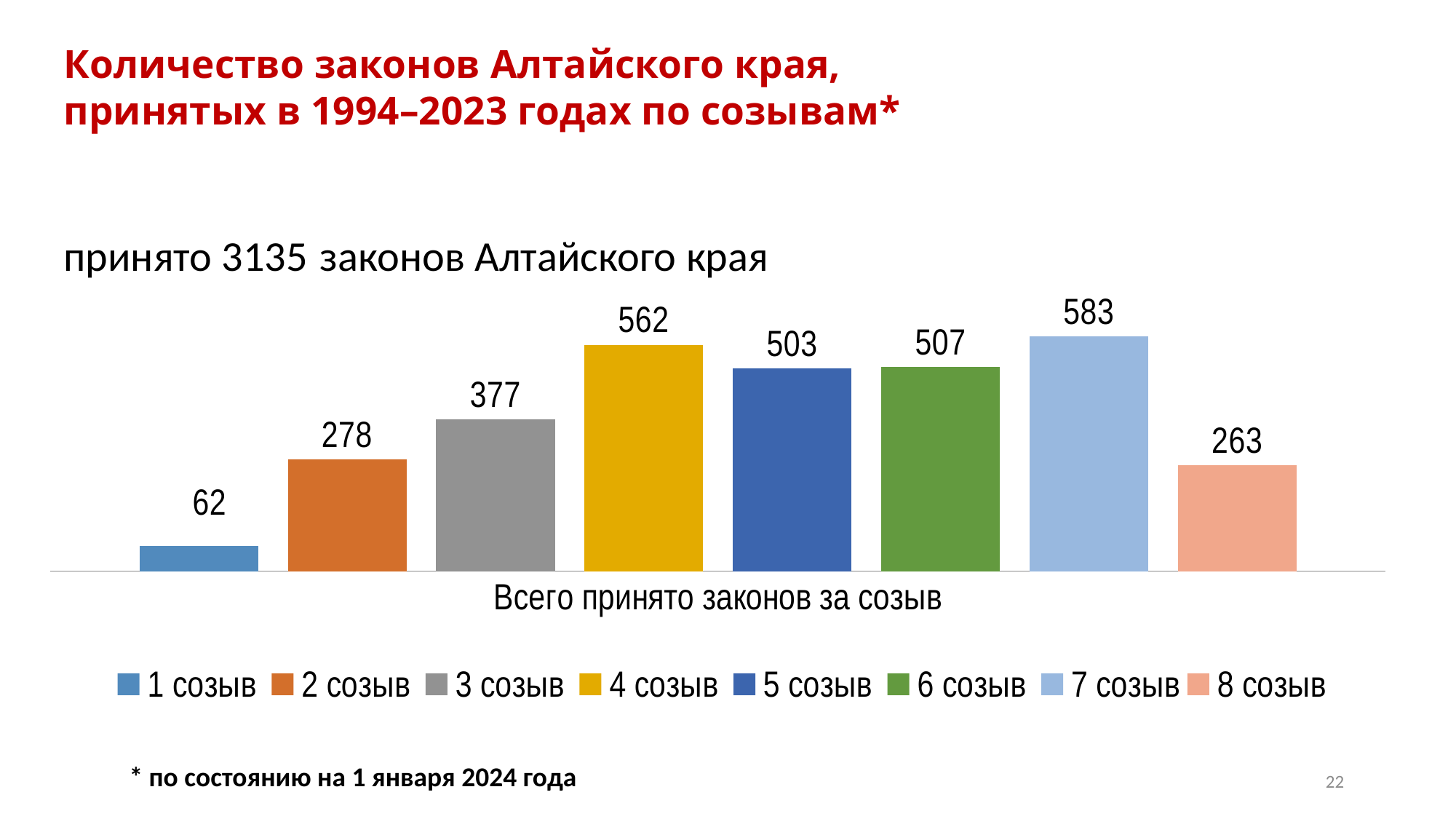
What kind of chart is shown on the slide? bar chart Which созыв has the highest number of laws adopted? 7 созыв What is the category label shown under the bars on the x axis? Всего принято законов за созыв How many bars are shown in the chart? 8 How many entries does the legend list? 8 Which is larger, the value for 2 созыв or the value for 8 созыв? 2 созыв What is the value for 4 созыв? 562 What is the difference between the values for 7 созыв and 4 созыв? 21 Which созыв has the lowest number of laws adopted? 1 созыв What is the value for 1 созыв? 62 What is the difference between the values for 3 созыв and 2 созыв? 99 What is the value for 8 созыв? 263